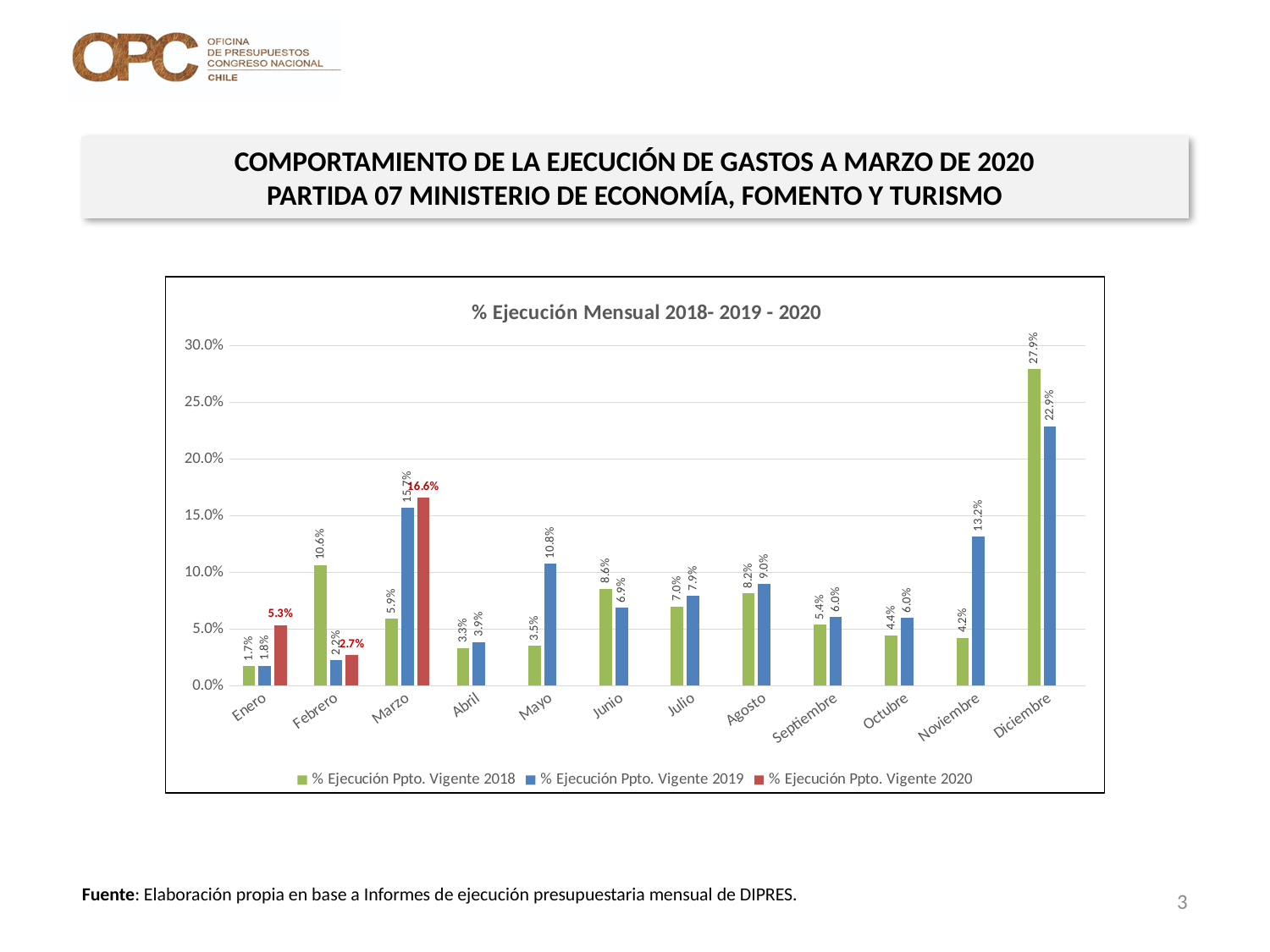
What is the title of the chart? % Ejecución Mensual 2018- 2019 - 2020 How many series does the legend list? 3 What is the difference between the 2018 and 2019 values for Diciembre? 5.0 percentage points What kind of chart is shown on the slide? Bar chart What is the value of % Ejecución Ppto. Vigente 2018 for Diciembre? 27.9% Which month has the highest value for % Ejecución Ppto. Vigente 2018? Diciembre For Febrero, which series is larger: % Ejecución Ppto. Vigente 2018 or % Ejecución Ppto. Vigente 2019? % Ejecución Ppto. Vigente 2018 How many months are shown on the x axis? 12 Is the value of % Ejecución Ppto. Vigente 2019 for Mayo greater or less than 10.0%? greater Which month has the lowest value for % Ejecución Ppto. Vigente 2018? Enero What is the value of % Ejecución Ppto. Vigente 2019 for Noviembre? 13.2% What is the value of % Ejecución Ppto. Vigente 2020 for Marzo? 16.6%